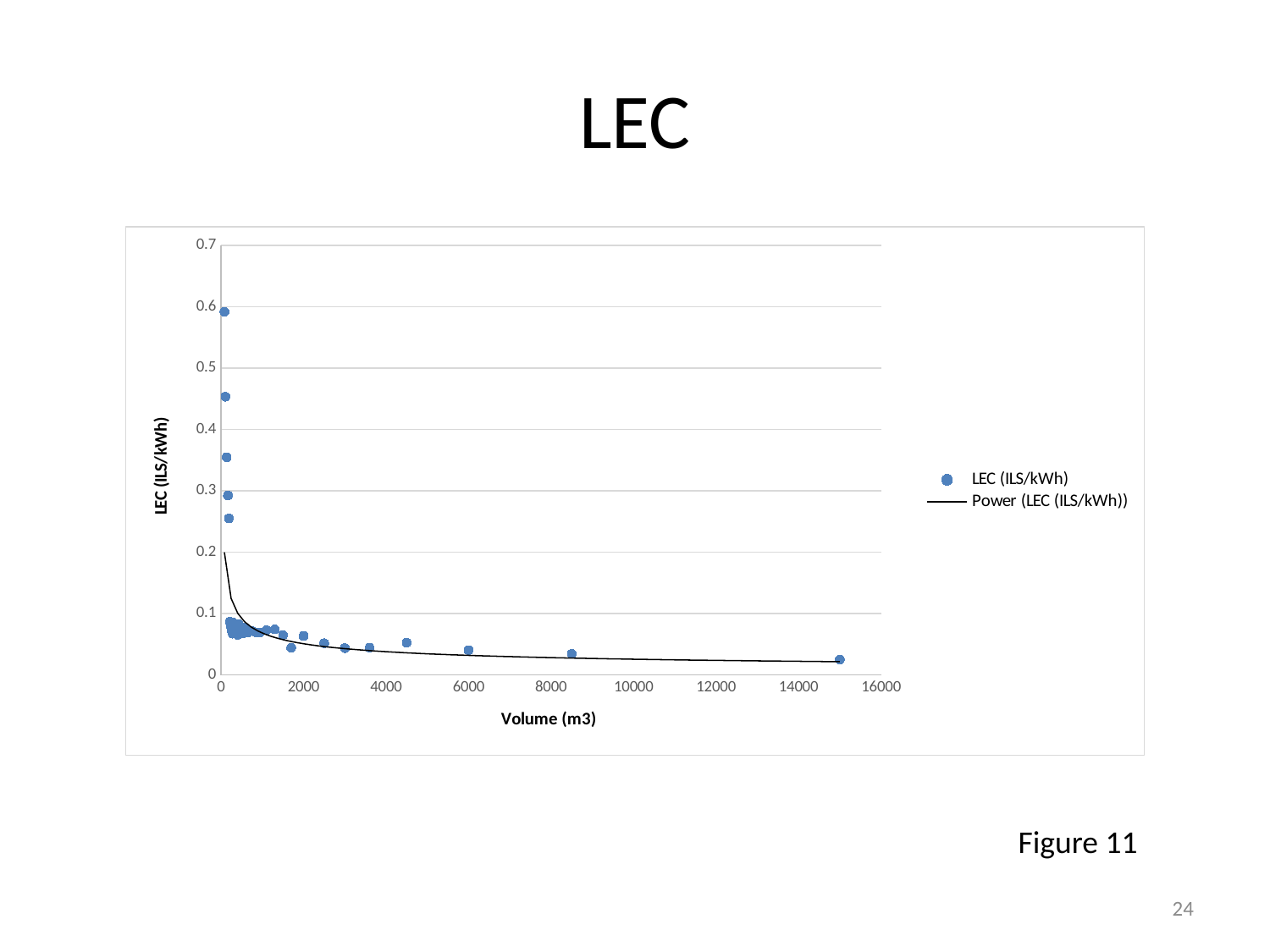
Do the LEC values generally rise or fall as Volume increases along the x axis? fall What is the title of the chart? LEC Is the LEC value for the point at about 15000 m3 greater or less than 0.1? less What kind of chart is shown on the slide? scatter chart Is the LEC value for the point at about 8500 m3 greater or less than 0.1? less Is the highest plotted LEC value greater or less than 0.5? greater How many series does the legend list? 2 What is the label of the x axis? Volume (m3) Which is larger: the LEC value of the point near 0 m3 at the top of the chart, or the LEC value of the point at about 15000 m3? the point near 0 m3